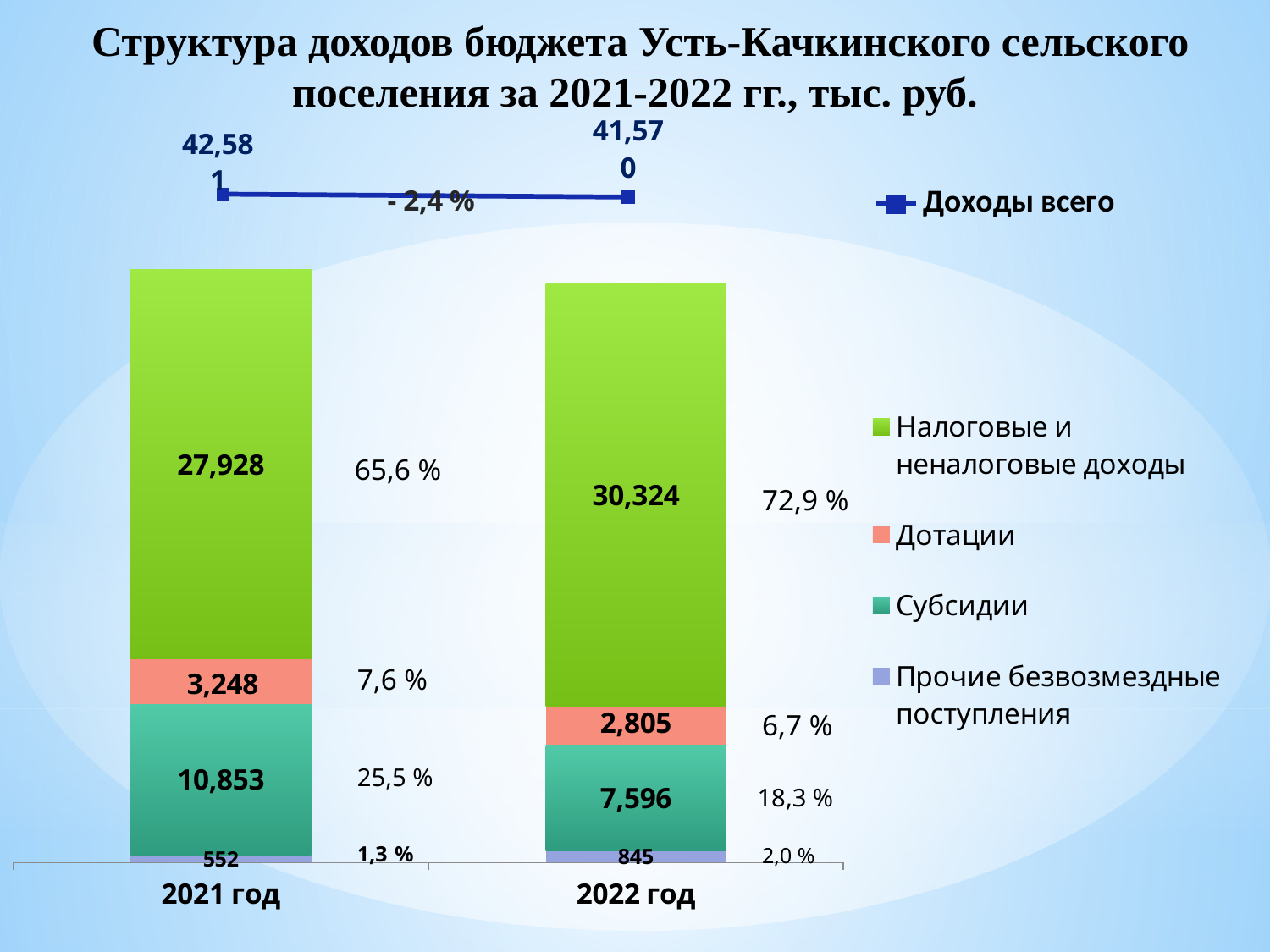
What is the value of Дотации for 2021 год? 3,248 Which is larger: Дотации in 2021 год or Дотации in 2022 год? 2021 год What is the difference between Субсидии in 2021 год and 2022 год? 3,257 What percentage change in Доходы всего is shown between 2021 and 2022? - 2,4 % What is the value of Налоговые и неналоговые доходы for 2021 год? 27,928 Which series is the largest segment in the 2022 год bar? Налоговые и неналоговые доходы How many categories (years) are shown on the x axis? 2 What is the total of the stacked bar for 2022 год (Доходы всего)? 41,570 What is the value of Субсидии for 2022 год? 7,596 What is the value of Прочие безвозмездные поступления for 2022 год? 845 What is the total of the stacked bar for 2021 год (Доходы всего)? 42,581 What percentage share is shown for Налоговые и неналоговые доходы in 2022 год? 72,9 %